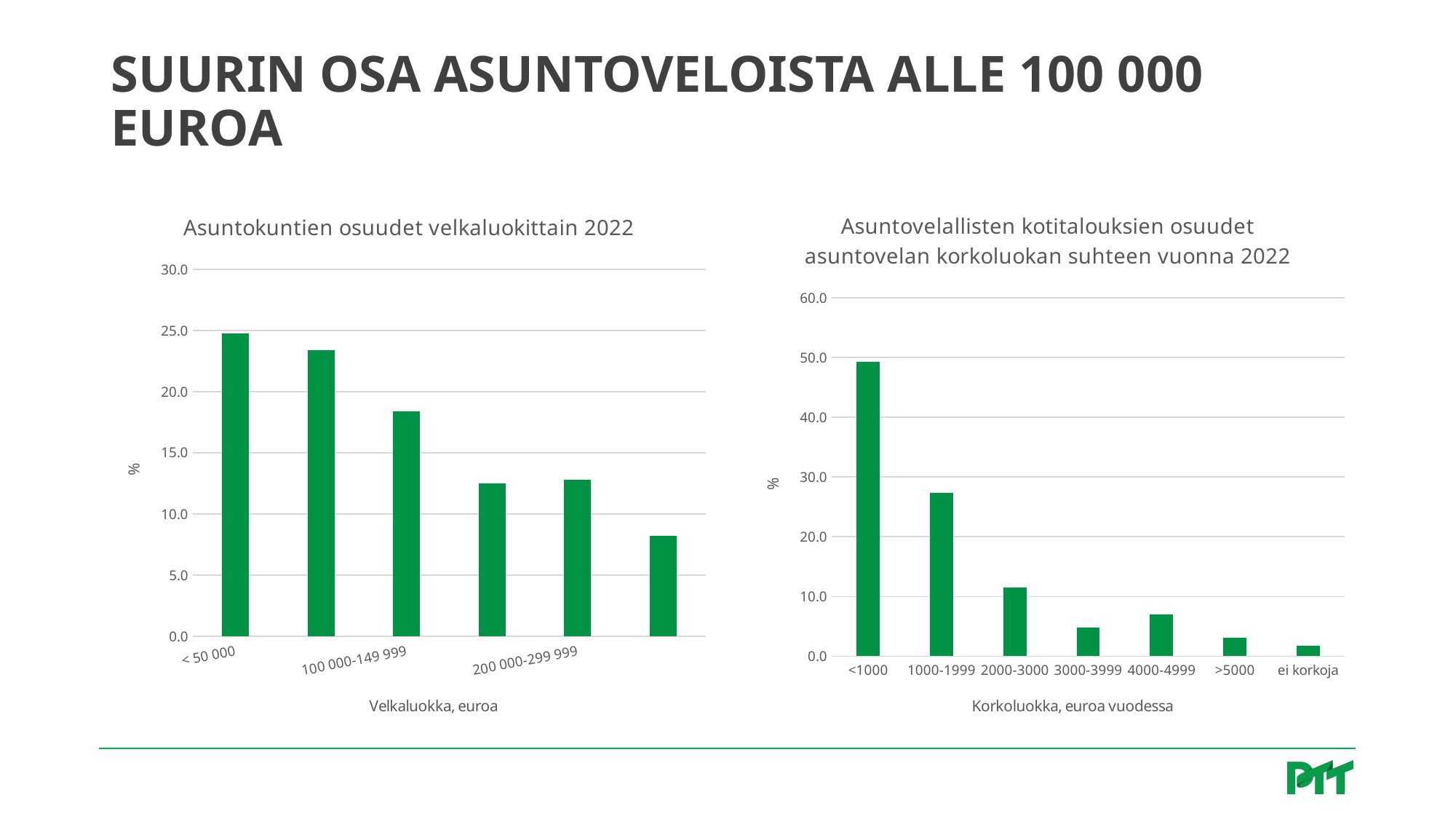
In the right chart, which interest category has the highest share? <1000 In the left chart, is the value for '200 000-299 999' greater or less than 15.0? less In the right chart, which interest category has the lowest share? ei korkoja In the right chart, is the value for '<1000' greater or less than 40.0? greater How many bars does the right chart, 'Asuntovelallisten kotitalouksien osuudet asuntovelan korkoluokan suhteen vuonna 2022', have? 7 In the left chart, is the value for '100 000-149 999' greater or less than 20.0? less In the right chart, which is larger: the value for '3000-3999' or the value for '4000-4999'? 4000-4999 How many bars does the left chart, 'Asuntokuntien osuudet velkaluokittain 2022', have? 6 In the left chart, which debt category has the highest share? < 50 000 What is the x-axis label of the right chart? Korkoluokka, euroa vuodessa What kind of chart is the left chart, 'Asuntokuntien osuudet velkaluokittain 2022'? bar chart